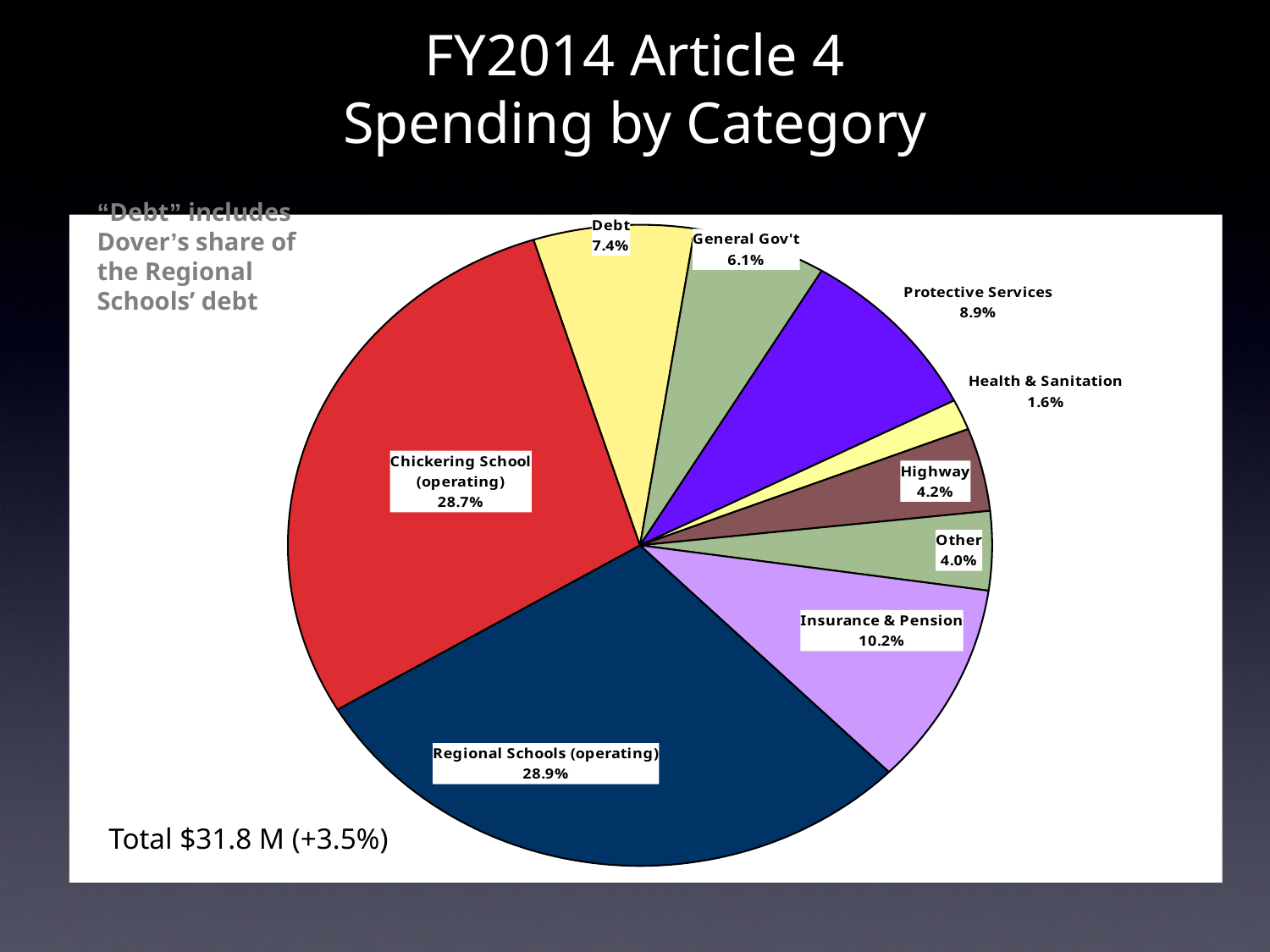
What percentage is shown for Protective Services? 8.9% Which is larger, Highway or Other? Highway What is the difference in percentage points between Debt and General Gov't? 1.3% What share of spending is Debt? 7.4% Which category has the smallest share of spending? Health & Sanitation What is the difference between Insurance & Pension and Protective Services? 1.3% What is the percentage for Chickering School (operating)? 28.7% What percentage of spending goes to Insurance & Pension? 10.2% What total spending amount is stated on the slide? $31.8 M (+3.5%) How many categories are shown in the pie chart? 9 What kind of chart is shown on the slide? Pie chart Which category has the largest share of spending? Regional Schools (operating)